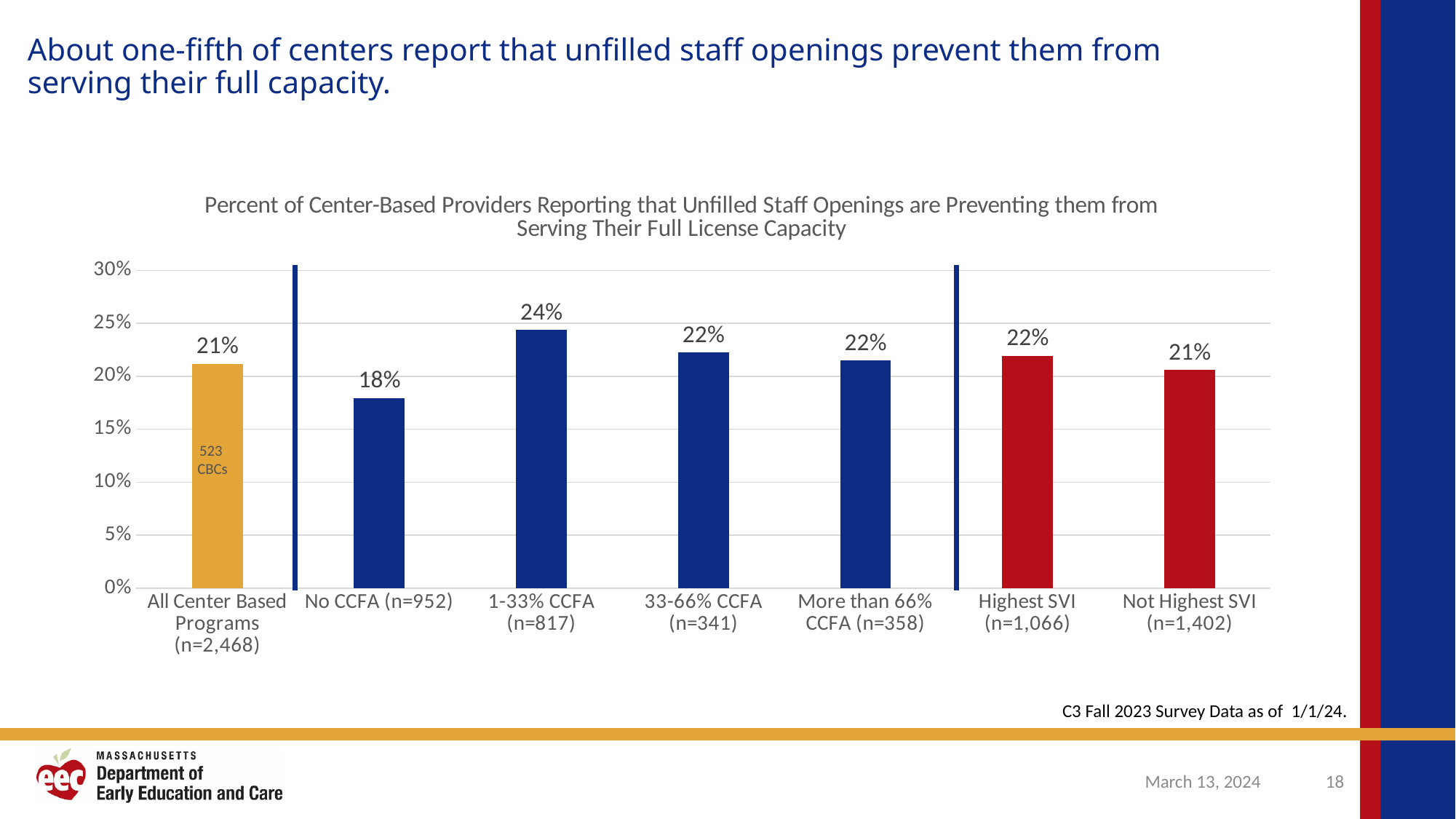
Is the value for No CCFA (n=952) greater or less than 20%? less How many categories (bars) are shown in the chart? 7 Which category has the highest percentage in the chart? 1-33% CCFA (n=817) What kind of chart is shown on the slide? Bar chart What is the value shown for the 1-33% CCFA (n=817) bar? 24% What is the value shown for Highest SVI (n=1,066)? 22% What percent of providers with No CCFA (n=952) report that unfilled staff openings are preventing them from serving their full license capacity? 18% Which is larger, the value for No CCFA (n=952) or the value for Not Highest SVI (n=1,402)? Not Highest SVI (n=1,402) What is the difference in percentage points between the 1-33% CCFA bar and the No CCFA bar? 6 percentage points What text label is printed inside the All Center Based Programs bar? 523 CBCs What is the value shown for All Center Based Programs (n=2,468)? 21% Which category has the lowest percentage in the chart? No CCFA (n=952)